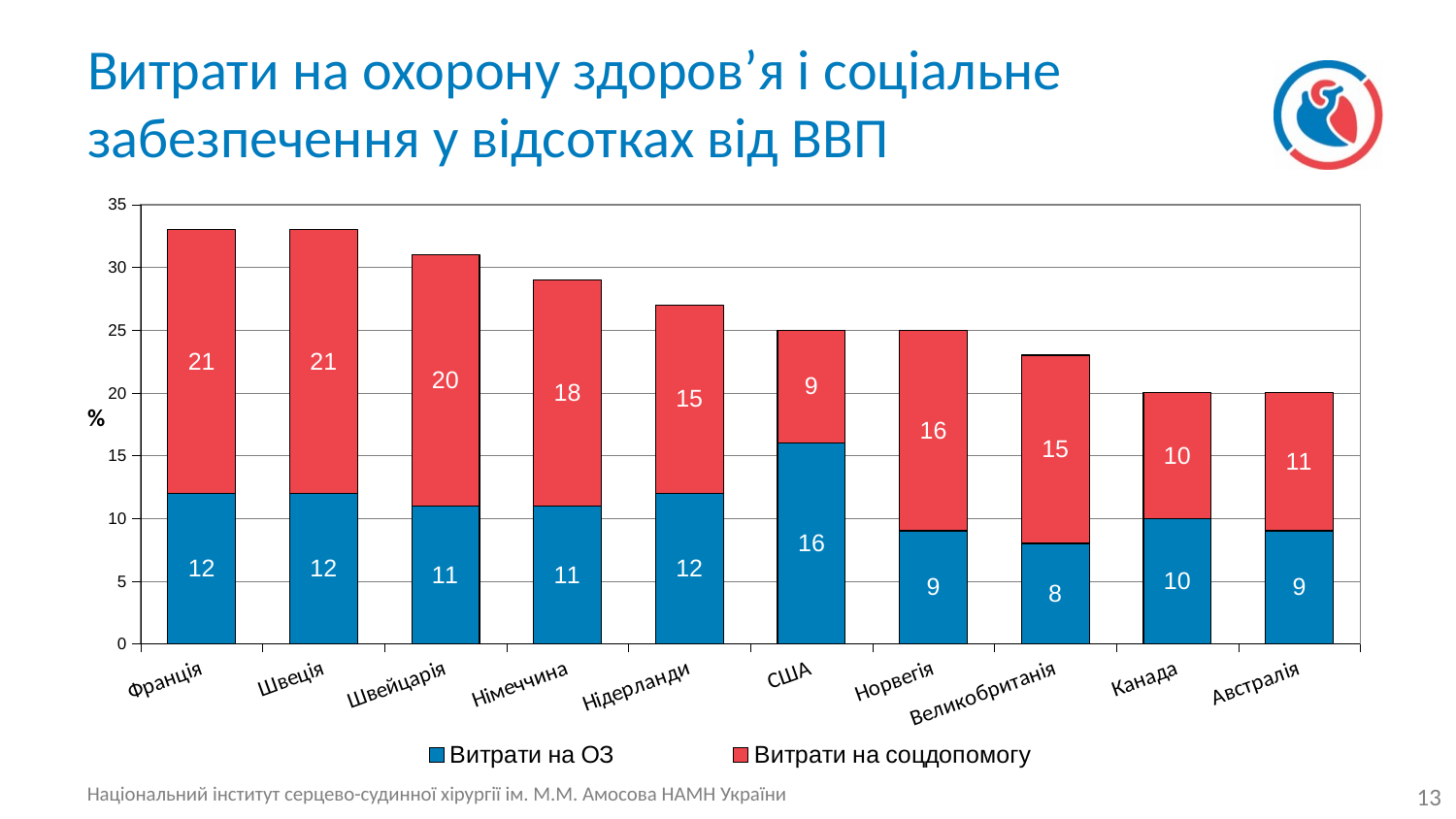
What is the value of Витрати на ОЗ for Великобританія? 8 Which country has the lowest value for Витрати на соцдопомогу? США What is the total of the stacked bar for Швейцарія? 31 How many series does the legend list? 2 What is the value of Витрати на соцдопомогу for Німеччина? 18 What kind of chart is shown on the slide? Stacked bar chart Which is larger: Витрати на ОЗ for США or Витрати на ОЗ for Норвегія? США How many countries are shown on the x axis? 10 What is the value of Витрати на ОЗ for США? 16 What is the total of the stacked bar for Норвегія? 25 Which country has the lowest value for Витрати на ОЗ? Великобританія What is the difference between Витрати на соцдопомогу for Франція and for Канада? 11